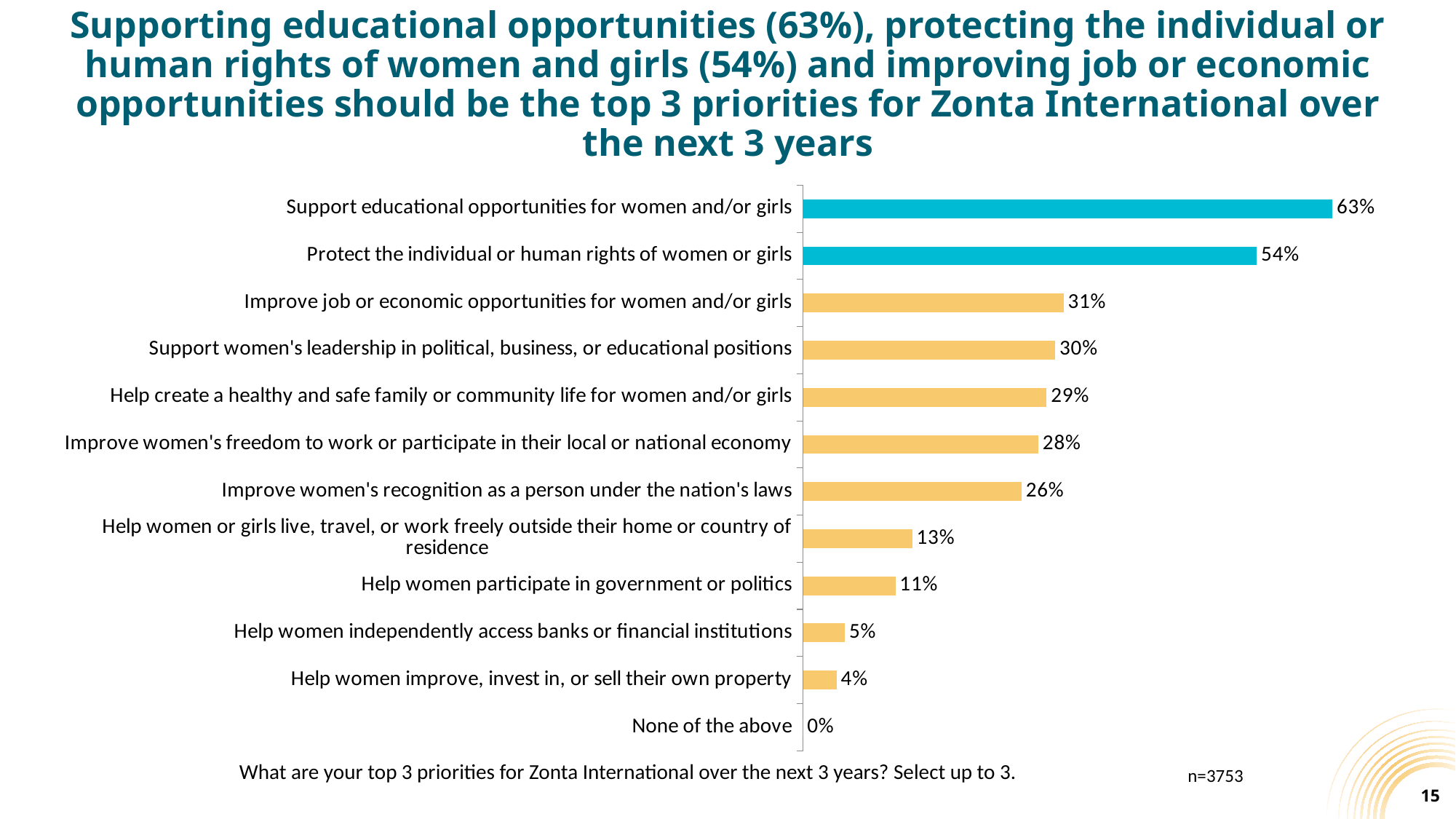
What is the value for 'Help women participate in government or politics'? 11% How many bars are coloured teal rather than yellow? 2 What is the value for 'Improve women's recognition as a person under the nation's laws'? 26% What is the sample size (n) shown on the slide? n=3753 What type of chart is shown on the slide? Bar chart What is the difference between 'Help women or girls live, travel, or work freely outside their home or country of residence' and 'Help women participate in government or politics'? 2% Which category has the lowest value in the chart? None of the above What is the difference between the values for 'Support educational opportunities for women and/or girls' and 'Protect the individual or human rights of women or girls'? 9% How many categories are shown in the chart? 12 Which category has the highest value in the chart? Support educational opportunities for women and/or girls Which is larger: the value for 'Improve job or economic opportunities for women and/or girls' or the value for 'Help create a healthy and safe family or community life for women and/or girls'? Improve job or economic opportunities for women and/or girls What percentage of respondents selected 'Support educational opportunities for women and/or girls' as a top priority? 63%